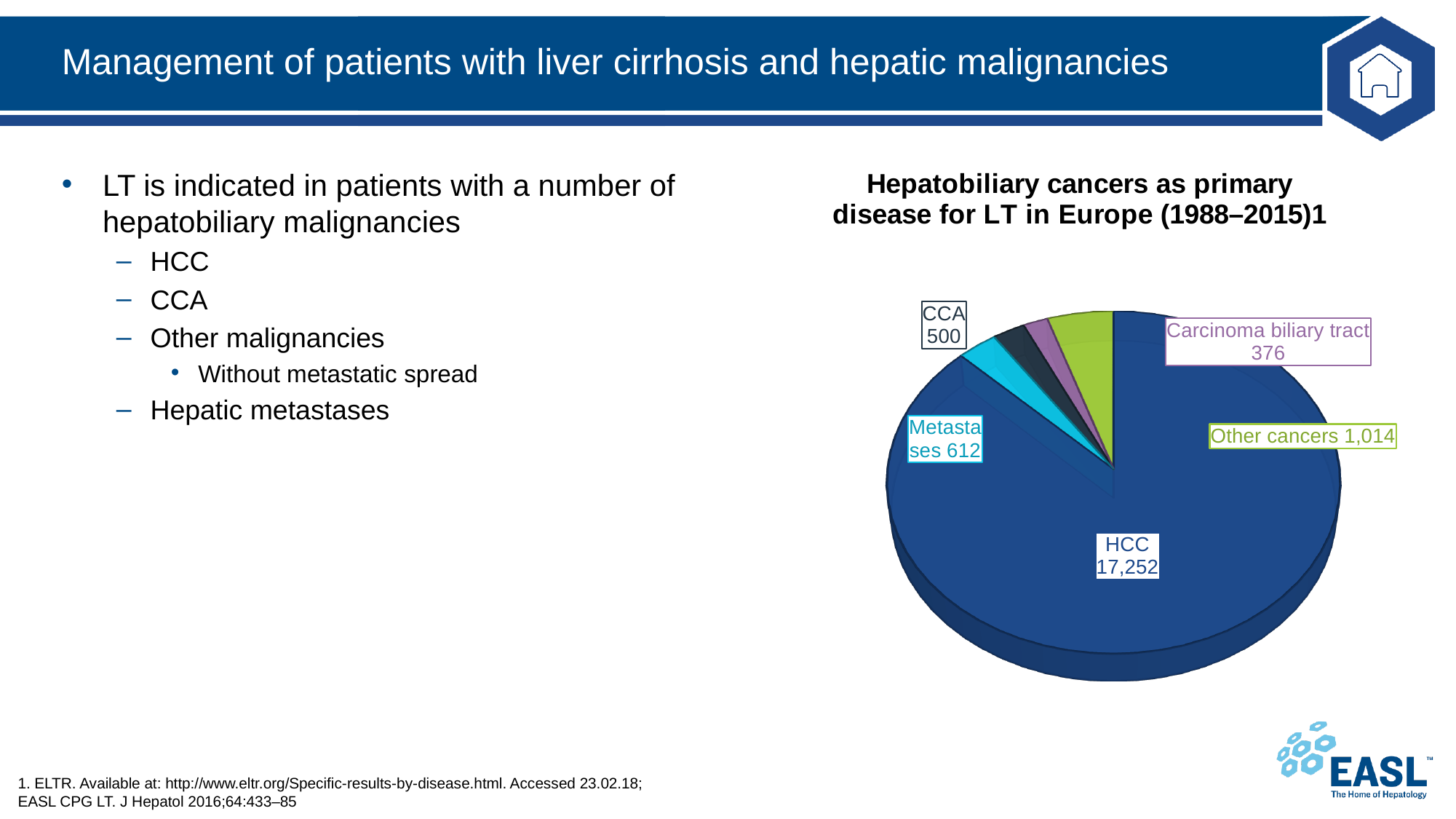
What type of chart is shown on the slide? Pie chart What is the title of the pie chart? Hepatobiliary cancers as primary disease for LT in Europe (1988–2015) What is the value for Metastases in the pie chart? 612 What is the value for Carcinoma biliary tract in the pie chart? 376 How many slices does the pie chart have? 5 Which category has the largest slice of the pie chart? HCC What is the value for HCC in the pie chart? 17,252 What is the difference between the values for HCC and Other cancers? 16,238 What is the value for Other cancers in the pie chart? 1,014 Which is larger, the value for CCA or the value for Carcinoma biliary tract? CCA What is the difference between the values for Metastases and CCA? 112 Which category has the smallest slice of the pie chart? Carcinoma biliary tract